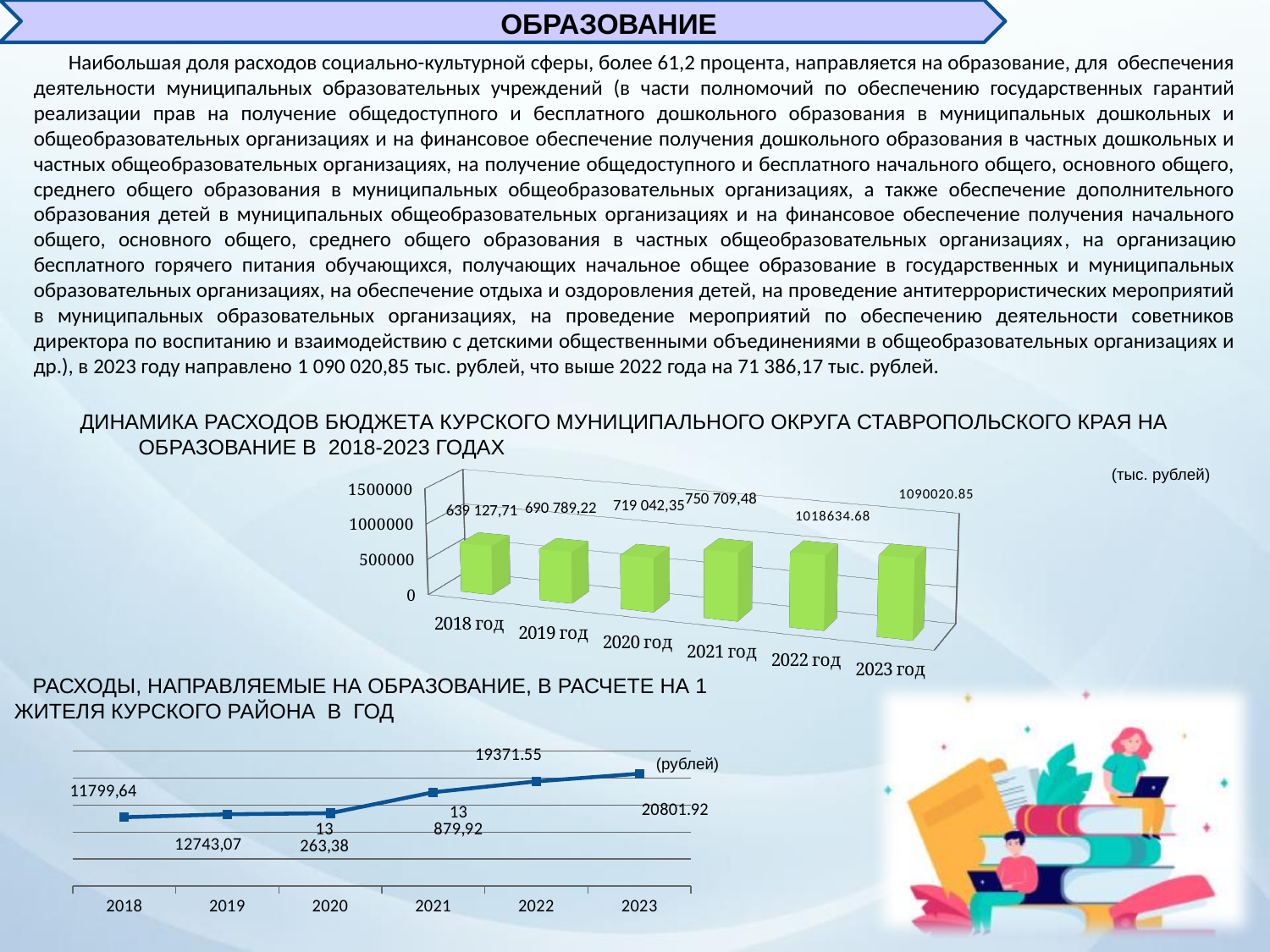
In the bar chart 'ДИНАМИКА РАСХОДОВ БЮДЖЕТА КУРСКОГО МУНИЦИПАЛЬНОГО ОКРУГА', how many years are shown? 6 In the lower chart 'РАСХОДЫ, НАПРАВЛЯЕМЫЕ НА ОБРАЗОВАНИЕ, В РАСЧЕТЕ НА 1 ЖИТЕЛЯ', which is larger, the value for 2019 or the value for 2022? 2022 In the bar chart 'ДИНАМИКА РАСХОДОВ БЮДЖЕТА КУРСКОГО МУНИЦИПАЛЬНОГО ОКРУГА', what is the value for 2023 год? 1090020.85 In the bar chart 'ДИНАМИКА РАСХОДОВ БЮДЖЕТА КУРСКОГО МУНИЦИПАЛЬНОГО ОКРУГА', which year has the highest value? 2023 год In the lower chart 'РАСХОДЫ, НАПРАВЛЯЕМЫЕ НА ОБРАЗОВАНИЕ, В РАСЧЕТЕ НА 1 ЖИТЕЛЯ', what is the value for 2018? 11799,64 In the bar chart 'ДИНАМИКА РАСХОДОВ БЮДЖЕТА КУРСКОГО МУНИЦИПАЛЬНОГО ОКРУГА', which year has the lowest value? 2018 год What type of chart is the upper chart 'ДИНАМИКА РАСХОДОВ БЮДЖЕТА КУРСКОГО МУНИЦИПАЛЬНОГО ОКРУГА'? bar chart What type of chart is the lower chart 'РАСХОДЫ, НАПРАВЛЯЕМЫЕ НА ОБРАЗОВАНИЕ, В РАСЧЕТЕ НА 1 ЖИТЕЛЯ'? line chart In the bar chart 'ДИНАМИКА РАСХОДОВ БЮДЖЕТА КУРСКОГО МУНИЦИПАЛЬНОГО ОКРУГА', do the values rise or fall from 2018 to 2023? rise In the bar chart 'ДИНАМИКА РАСХОДОВ БЮДЖЕТА КУРСКОГО МУНИЦИПАЛЬНОГО ОКРУГА', what is the value for 2018 год? 639 127,71 In the lower chart 'РАСХОДЫ, НАПРАВЛЯЕМЫЕ НА ОБРАЗОВАНИЕ, В РАСЧЕТЕ НА 1 ЖИТЕЛЯ', what is the value for 2023? 20801.92 In the bar chart 'ДИНАМИКА РАСХОДОВ БЮДЖЕТА КУРСКОГО МУНИЦИПАЛЬНОГО ОКРУГА', is the value for 2022 год greater or less than 1000000? greater